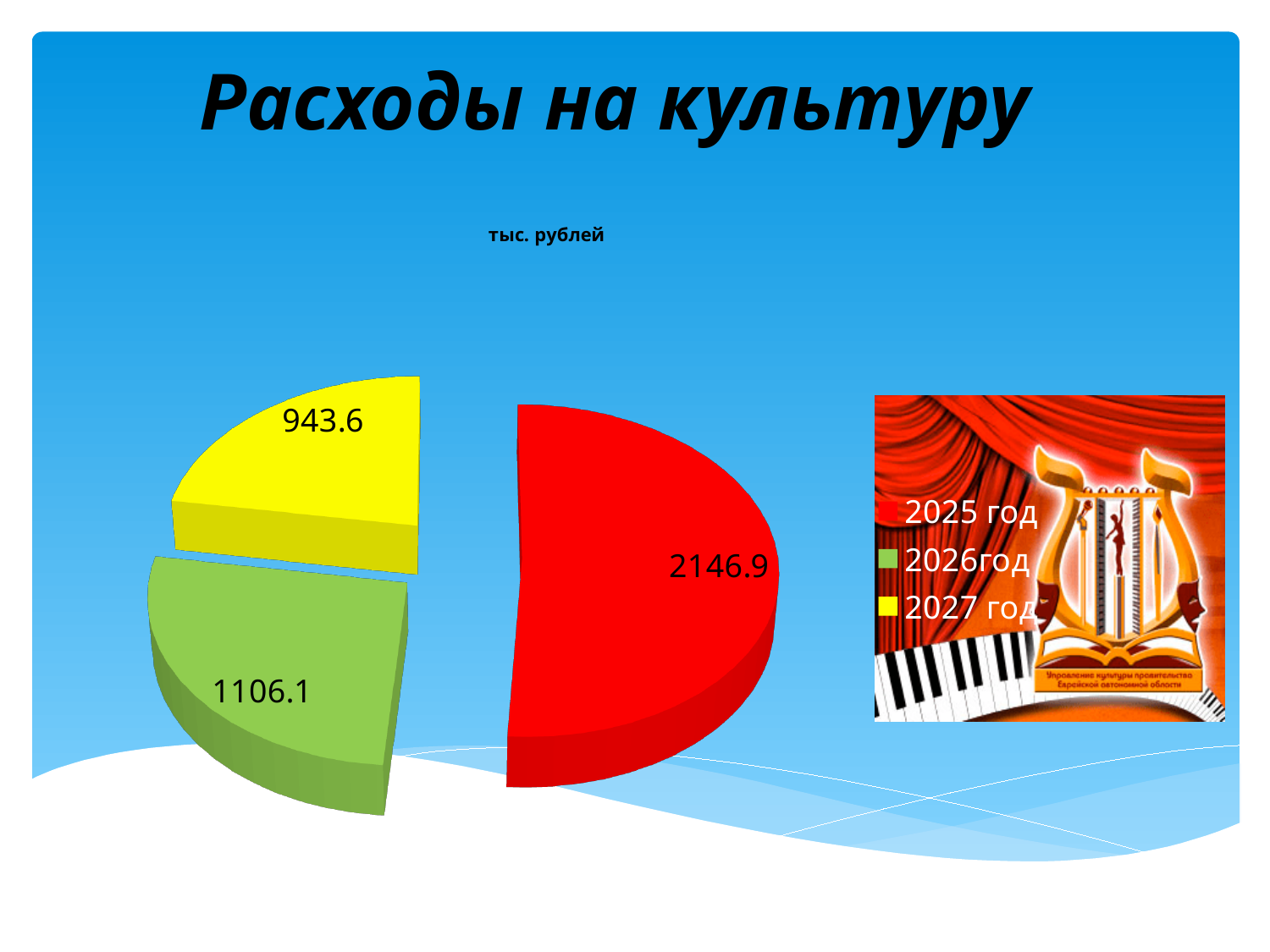
What is the value for 2026год in the pie chart? 1106.1 How many slices does the pie chart have? 3 What is the difference between the values for 2026год and 2027 год? 162.5 Is the 2025 год slice more or less than half of the pie? More Which year has the smallest slice in the pie chart? 2027 год What is the value for 2027 год in the pie chart? 943.6 What unit is given in the chart title? тыс. рублей What type of chart is shown on the slide? Pie chart What is the difference between the values for 2025 год and 2026год? 1040.8 Which is larger, the value for 2026год or the value for 2027 год? 2026год What is the value for 2025 год in the pie chart? 2146.9 Which year has the largest slice in the pie chart? 2025 год